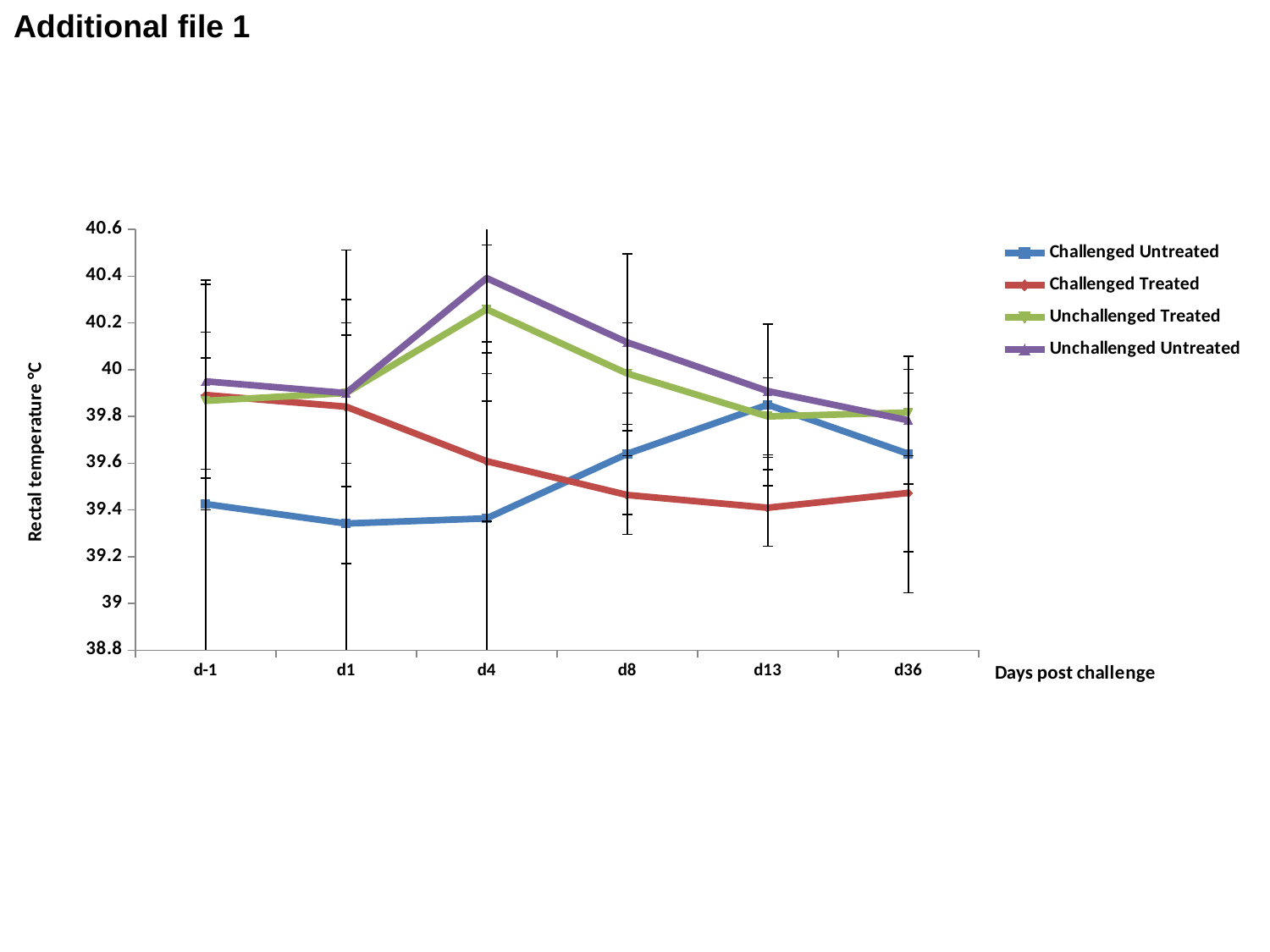
Is the value for Challenged Treated at d13 greater or less than 39.6? less How many series does the legend list? 4 At d13, which is larger: Challenged Untreated or Challenged Treated? Challenged Untreated What kind of chart is shown on the slide? line chart Which series has the lowest rectal temperature at d4? Challenged Untreated Is the value for Unchallenged Untreated at d4 greater or less than 40.2? greater Which series has the highest rectal temperature at d4? Unchallenged Untreated Is the value for Challenged Untreated at d1 greater or less than 39.6? less At which day does the Unchallenged Untreated series reach its peak? d4 Does the Challenged Treated series rise or fall from d-1 to d13? fall What is the title of the y axis? Rectal temperature °C How many days post challenge are plotted along the x axis? 6